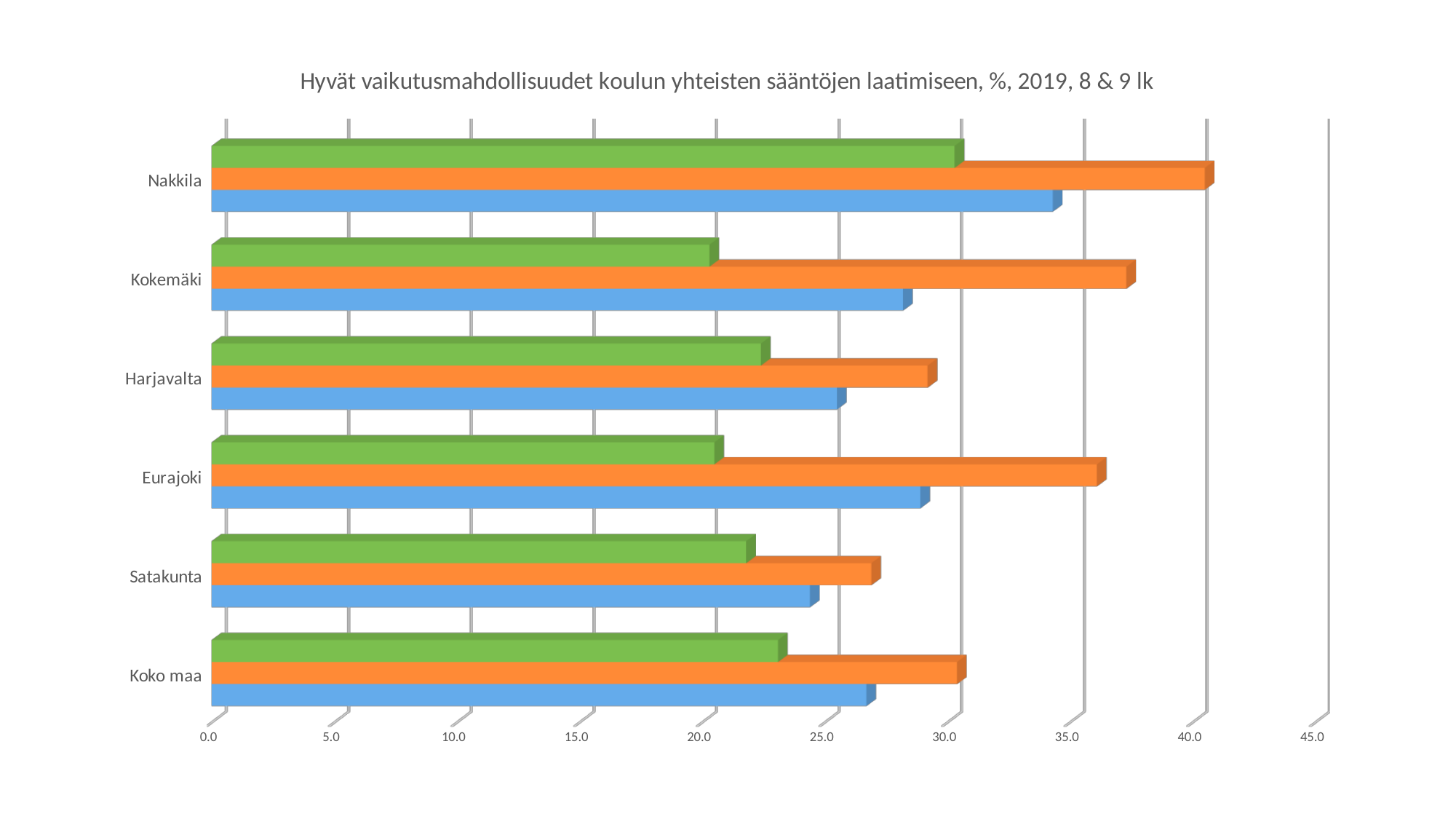
Is the green bar for Kokemäki greater or less than 25.0? less Is the orange bar for Nakkila greater or less than 35.0? greater Which category has the longest blue bar? Nakkila How many categories are shown on the vertical axis of the chart? 6 Is the blue bar for Koko maa greater or less than 25.0? greater Which category has the longest orange bar? Nakkila Which category has the shortest orange bar? Satakunta What is the highest value shown on the horizontal axis of the chart? 45.0 What kind of chart is shown on the slide? bar chart For Eurajoki, which is longer, the green bar or the orange bar? the orange bar Which is longer, the orange bar for Nakkila or the orange bar for Kokemäki? Nakkila